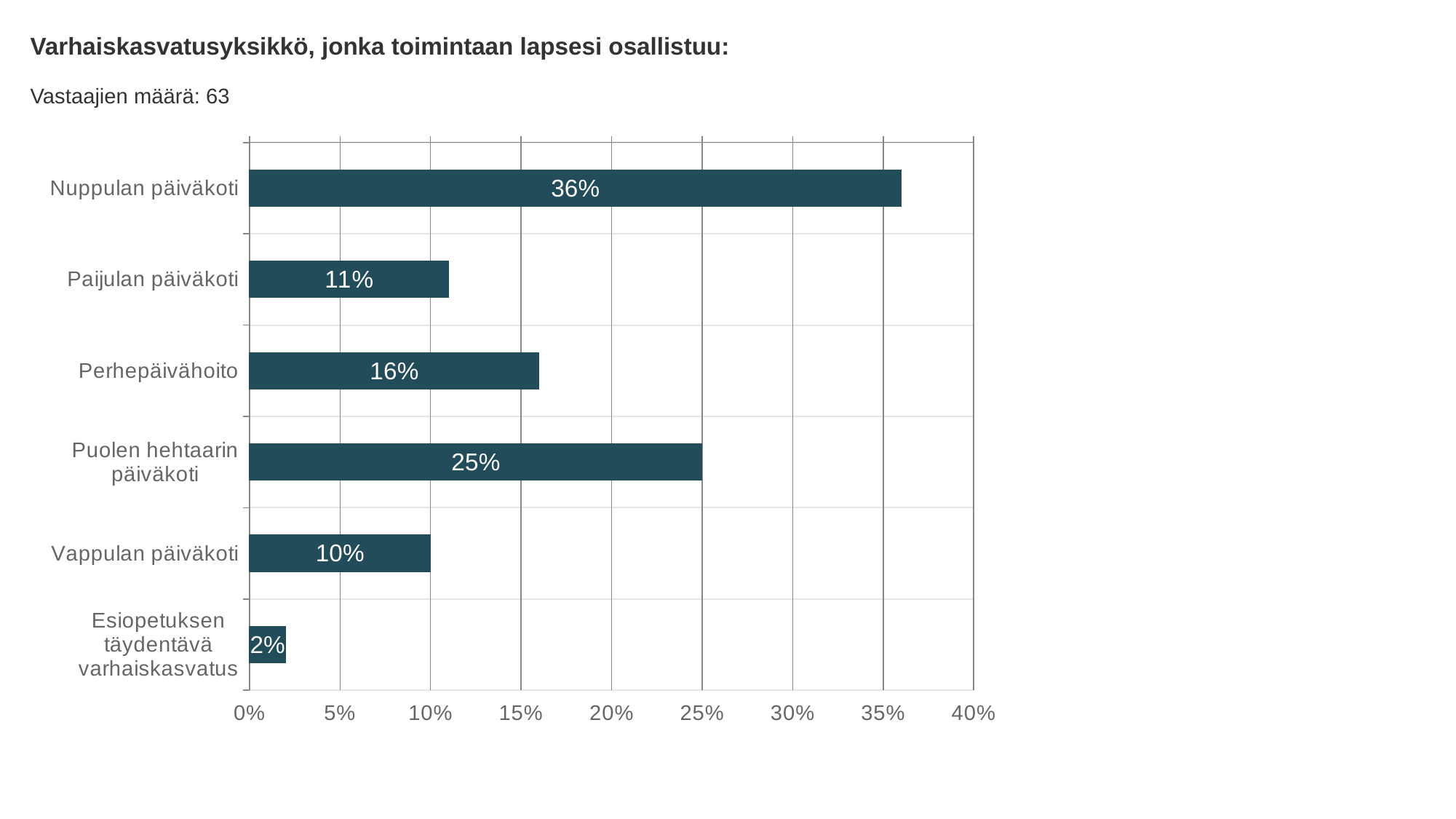
How many respondents (Vastaajien määrä) does the slide report? 63 Is the value for Puolen hehtaarin päiväkoti greater or less than 20%? greater What kind of chart is shown on the slide? bar chart What is the value for Perhepäivähoito? 16% What is the value for Nuppulan päiväkoti? 36% Which category has the highest value? Nuppulan päiväkoti How many categories are shown in the chart? 6 What is the value for Esiopetuksen täydentävä varhaiskasvatus? 2% Which category has the lowest value? Esiopetuksen täydentävä varhaiskasvatus What is the title of the chart? Varhaiskasvatusyksikkö, jonka toimintaan lapsesi osallistuu: What is the difference between the values for Nuppulan päiväkoti and Puolen hehtaarin päiväkoti? 11% Which is larger, the value for Paijulan päiväkoti or the value for Perhepäivähoito? Perhepäivähoito